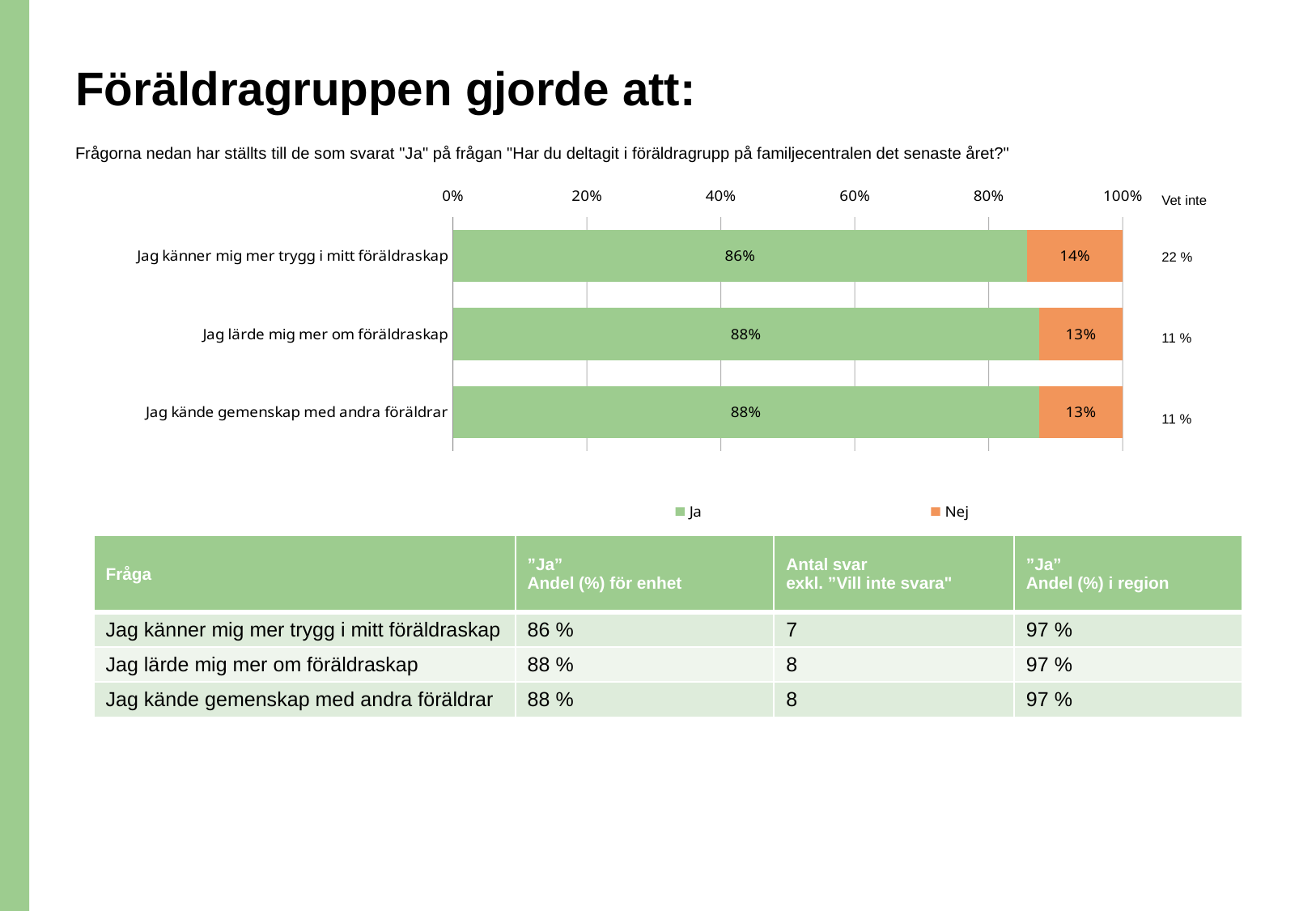
Is the "Ja" value for "Jag lärde mig mer om föräldraskap" greater or less than 80%? greater What is the "Ja" value for "Jag kände gemenskap med andra föräldrar"? 88% What is the "Nej" value for "Jag känner mig mer trygg i mitt föräldraskap"? 14% What is the difference between the "Ja" values for "Jag lärde mig mer om föräldraskap" and "Jag känner mig mer trygg i mitt föräldraskap"? 2% Which series is shown in orange in the chart? Nej How many categories are shown in the chart? 3 How many series does the legend list? 2 Which category has the highest "Nej" value? Jag känner mig mer trygg i mitt föräldraskap Which category has the lowest "Ja" value? Jag känner mig mer trygg i mitt föräldraskap What is the "Nej" value for "Jag lärde mig mer om föräldraskap"? 13% What is the "Ja" value for "Jag känner mig mer trygg i mitt föräldraskap"? 86% What kind of chart is shown on the slide? Stacked bar chart